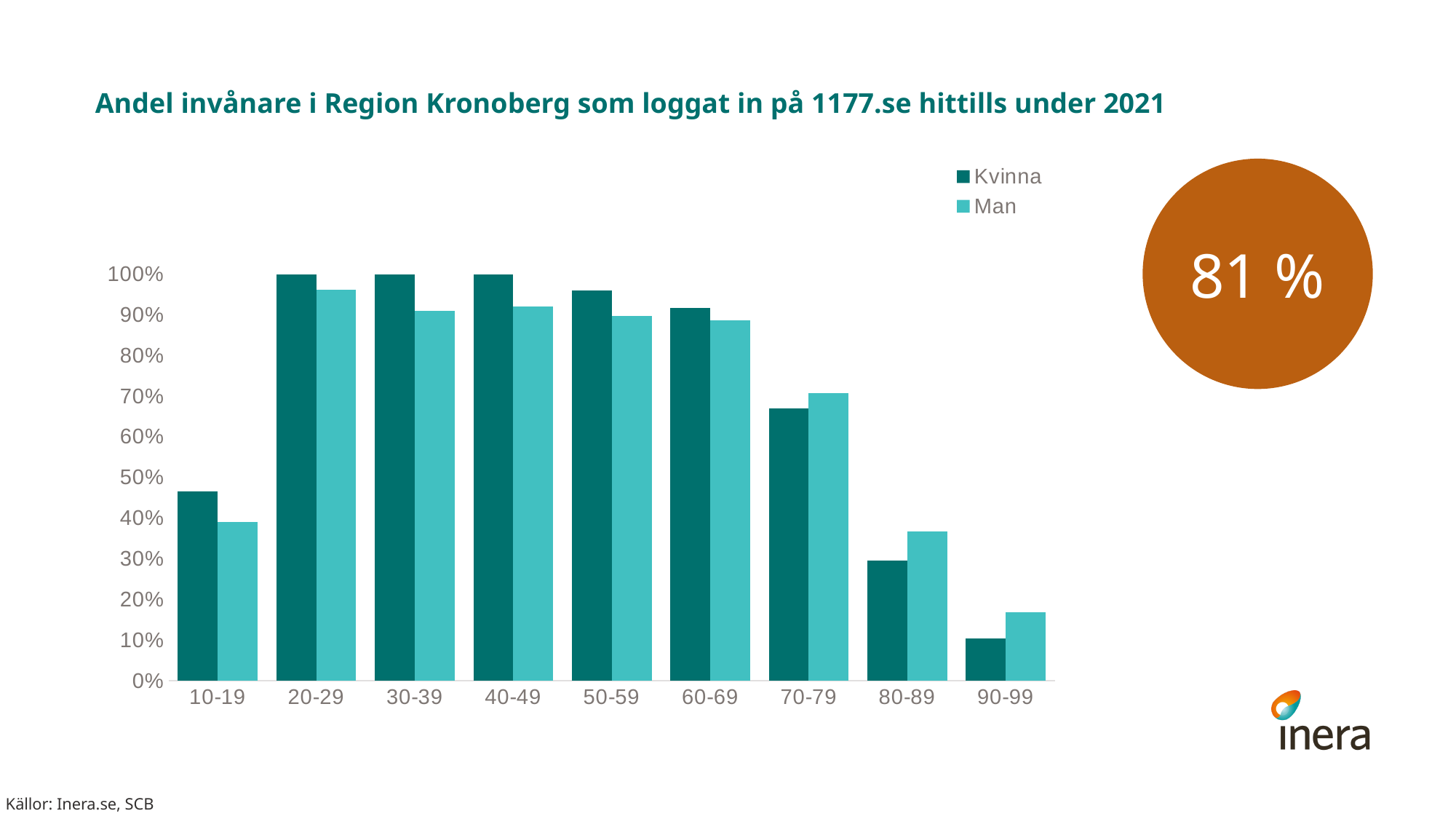
Which age group has the lowest value for Kvinna? 90-99 What kind of chart is shown on the slide? bar chart In the 70-79 age group, which series has the larger value, Kvinna or Man? Man How many series does the legend list? 2 Which age group has the lowest value for Man? 90-99 Is the value for Man in the 70-79 age group greater or less than 60%? greater What percentage is shown in the orange circle on the slide? 81 % How many age groups are shown on the x axis? 9 Is the value for Kvinna in the 80-89 age group greater or less than 40%? less In the 10-19 age group, which series has the larger value, Kvinna or Man? Kvinna